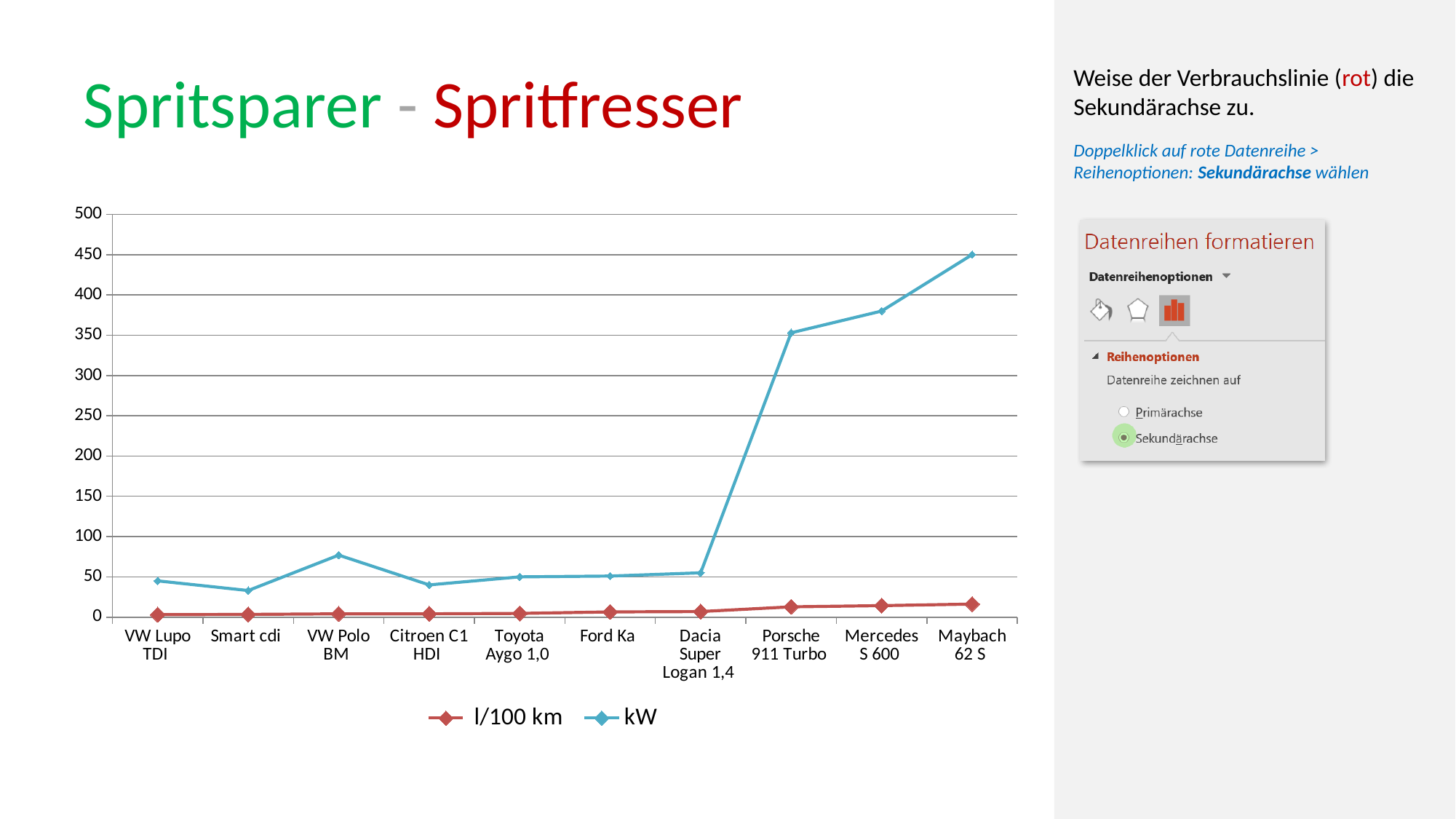
Is the kW value for VW Polo BM greater or less than 50? greater Which car has the highest kW value? Maybach 62 S How many series does the legend list? 2 What kind of chart is shown on the slide? line chart Is the kW value for Mercedes S 600 greater or less than 400? less Is the kW value for Porsche 911 Turbo greater or less than 300? greater Does the l/100 km line generally rise or fall from VW Lupo TDI to Maybach 62 S? rise Which car has the lowest kW value? Smart cdi What are the two series names shown in the legend? l/100 km and kW Which has the larger kW value, Porsche 911 Turbo or Dacia Super Logan 1,4? Porsche 911 Turbo How many car models are plotted along the x axis? 10